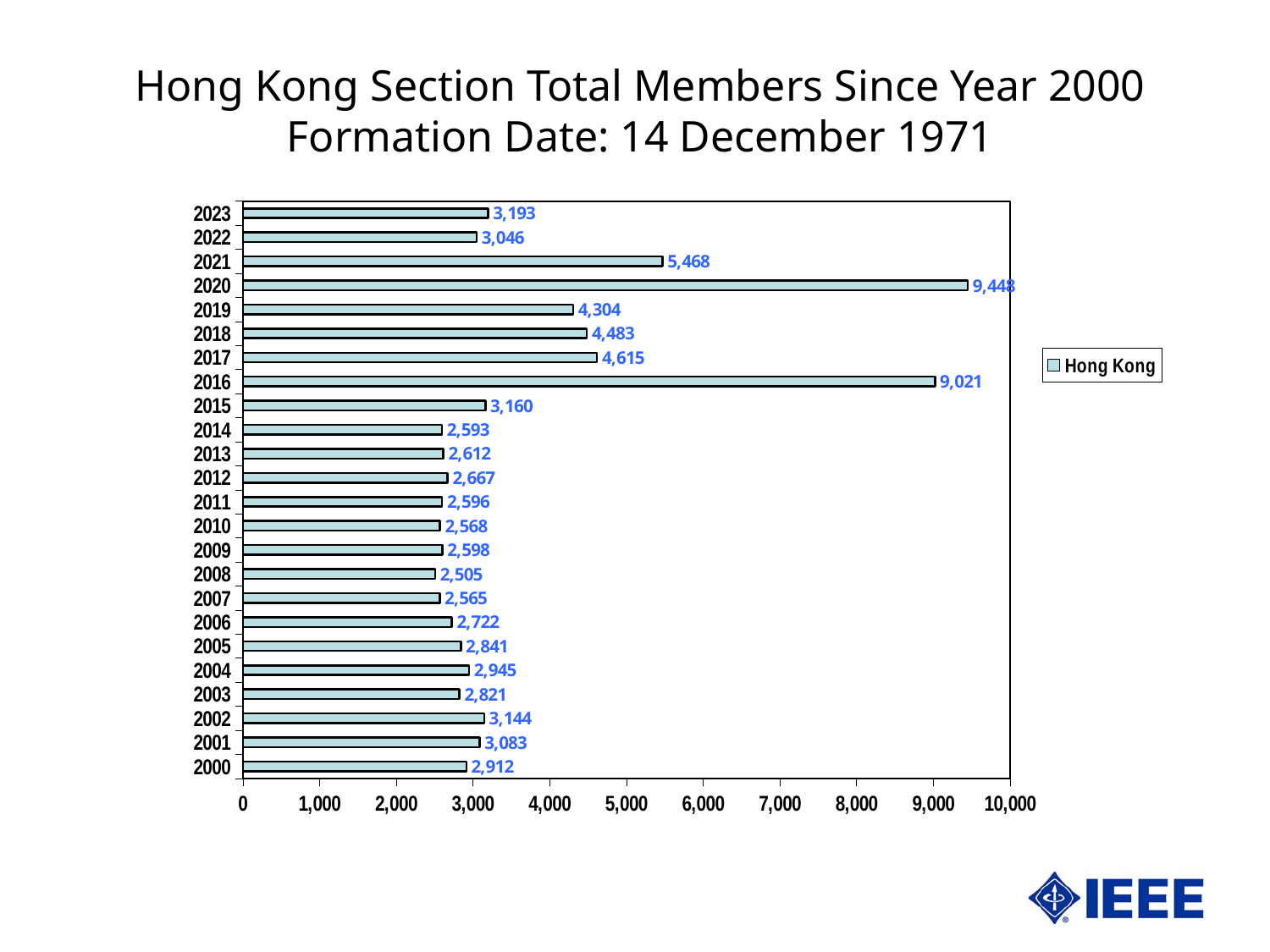
Is the value for 2017 greater or less than 4,000? greater Which year has the highest value? 2020 How many series does the legend list? 1 What is the value for 2020? 9,448 What kind of chart is shown? bar chart Which is larger, the value for 2021 or the value for 2019? 2021 How many years are shown on the chart? 24 What series name appears in the legend? Hong Kong What is the value for 2023? 3,193 Which year has the lowest value? 2008 What is the difference between the values for 2020 and 2016? 427 What is the value for 2008? 2,505